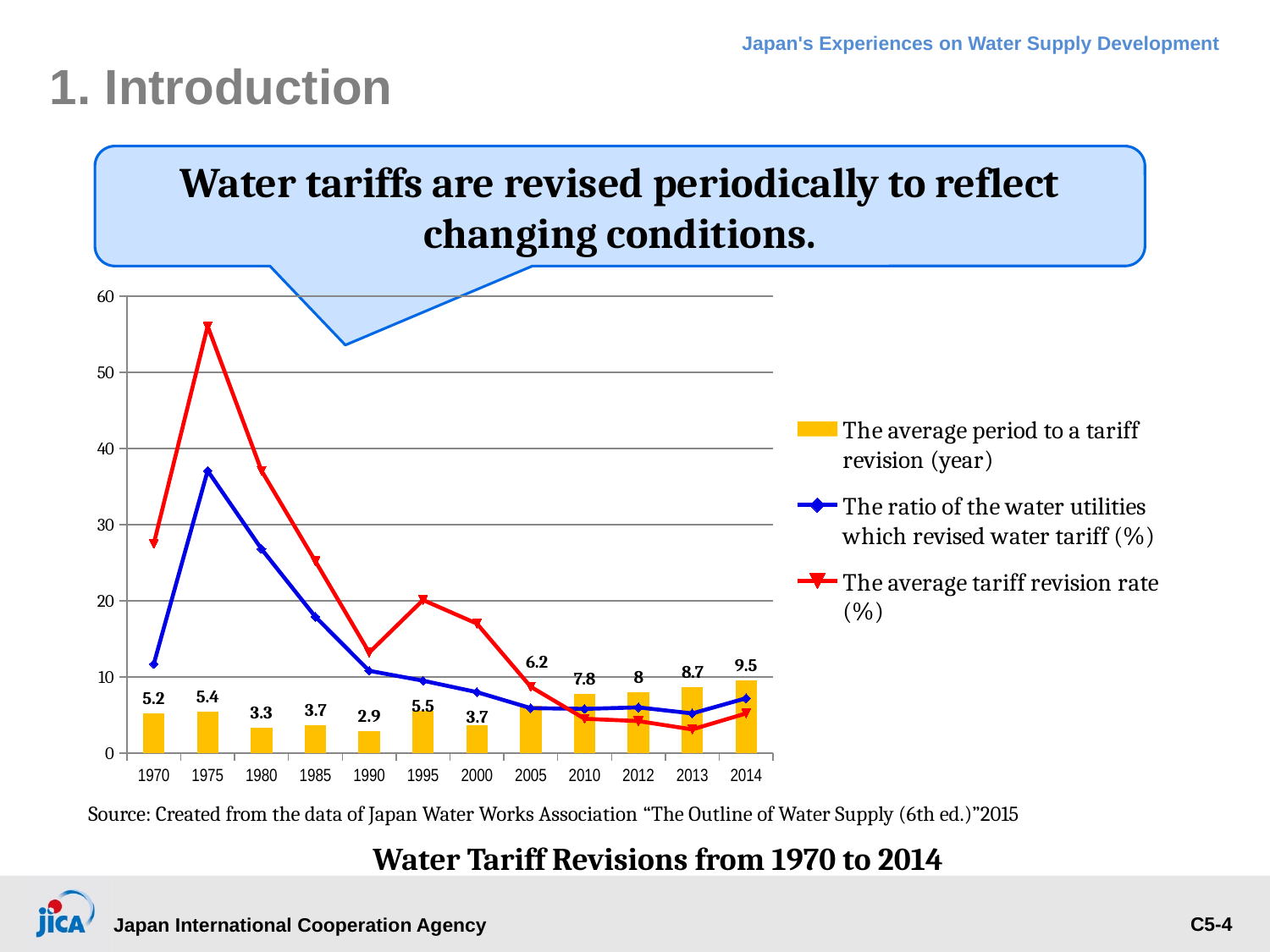
What is the average period to a tariff revision (year) shown for 1990? 2.9 In which year is the average period to a tariff revision the lowest? 1990 Is the ratio of the water utilities which revised water tariff (%) for 1975 greater or less than 30? greater How many series does the legend list? 3 What is the average period to a tariff revision (year) shown for 2014? 9.5 What is the average period to a tariff revision (year) shown for 2005? 6.2 Which year has a longer average period to a tariff revision, 1995 or 2000? 1995 Is the average tariff revision rate (%) for 1975 greater or less than 50? greater How many years are shown on the x axis of the chart? 12 In which year is the average period to a tariff revision the highest? 2014 Does the average tariff revision rate (%) rise or fall from 1975 to 1990? fall What is the difference between the average period to a tariff revision in 2014 and in 1970? 4.3